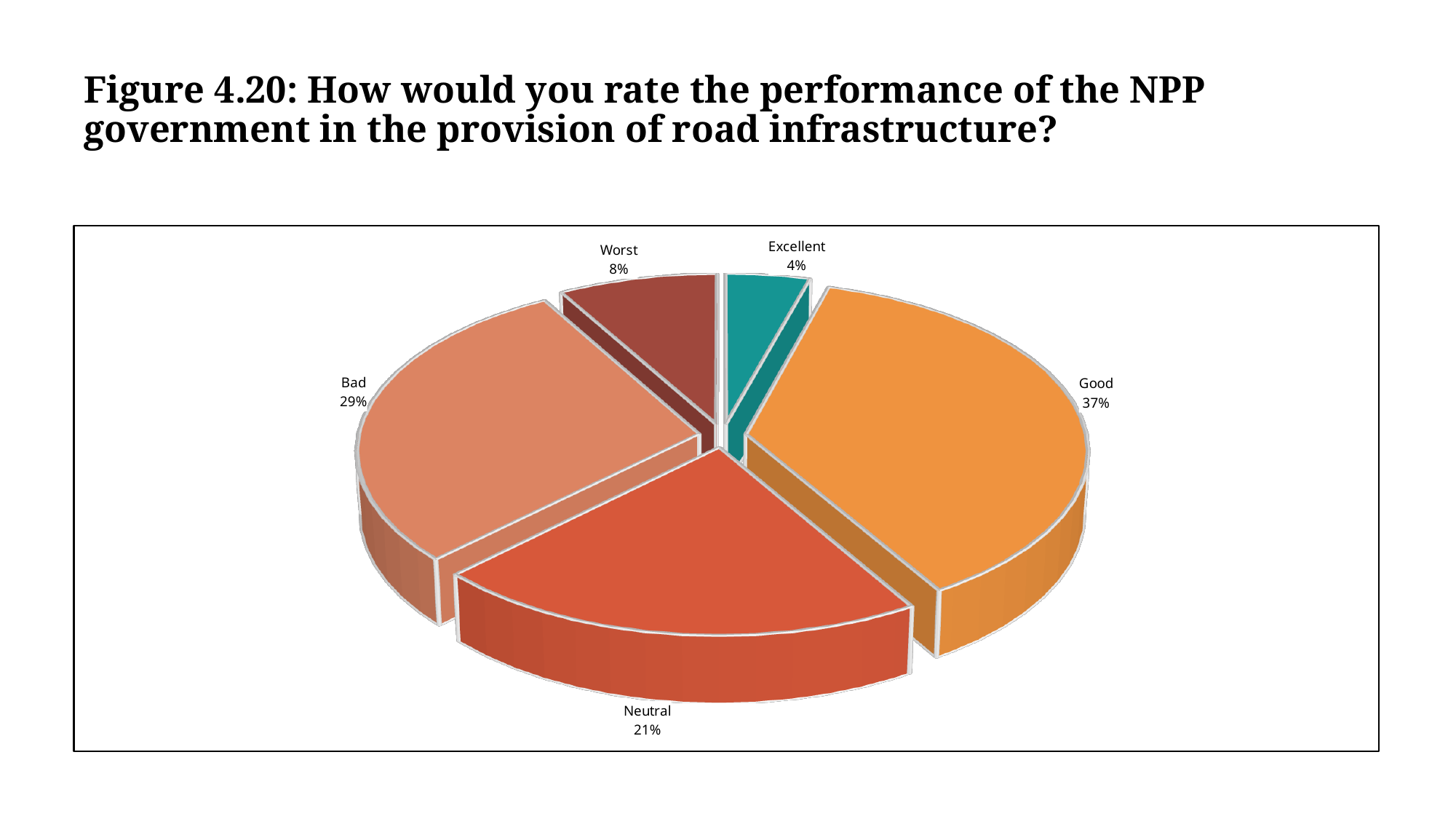
What percentage is shown for the Excellent slice? 4% How many percentage points larger is the Good slice than the Bad slice? 8 How many categories are shown in the pie chart? 5 Which is larger, the Neutral slice or the Bad slice? Bad What percentage is shown for the Neutral slice? 21% What is the difference in percentage points between the Worst and Excellent slices? 4 What kind of chart is shown on the slide? Pie chart Which rating category has the largest share of the pie? Good What share of the pie is labelled Bad? 29% What percentage of respondents rated the NPP government's road infrastructure performance as Good? 37% What colour is the Excellent slice? Teal Which rating category has the smallest share of the pie? Excellent